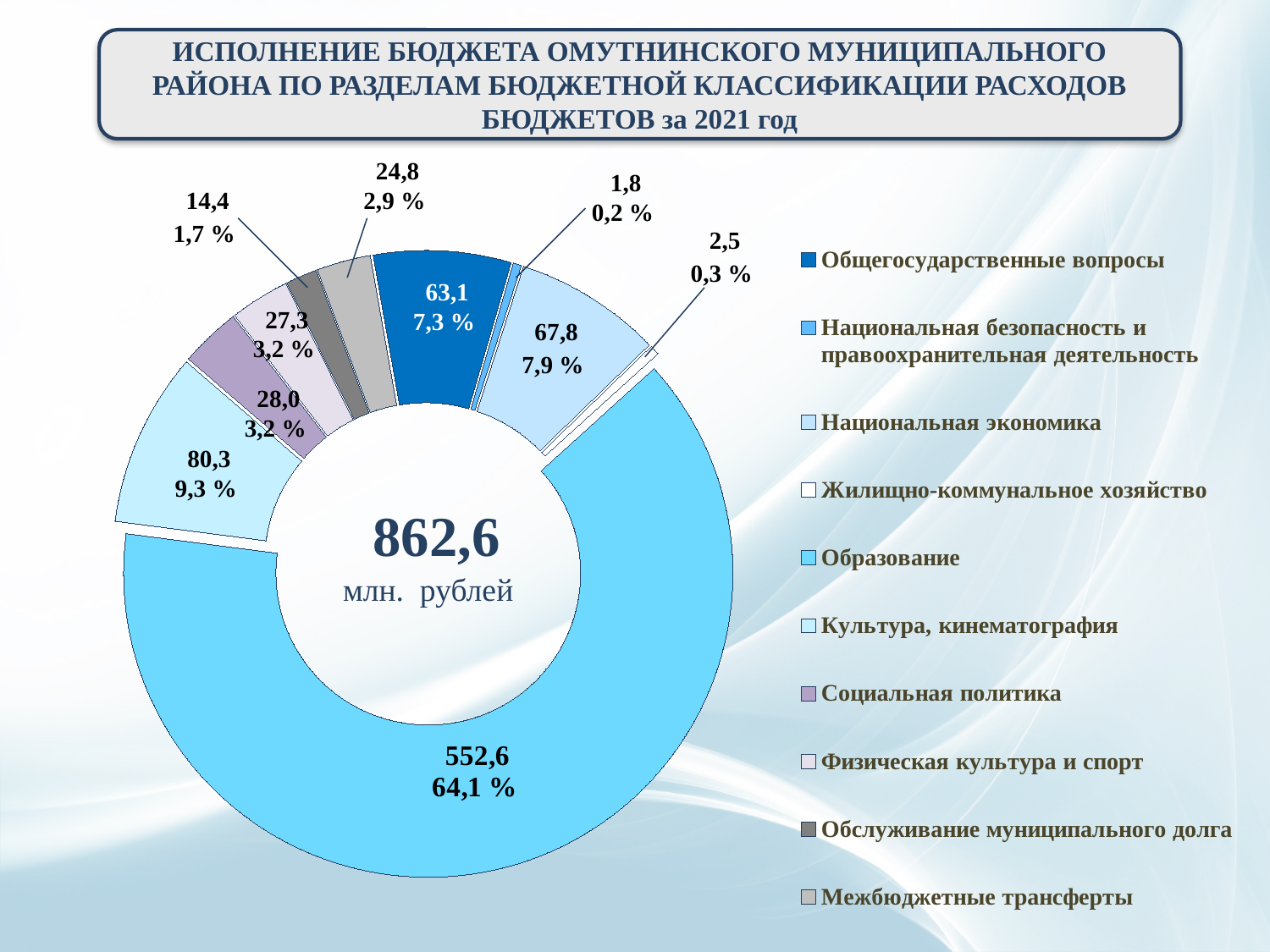
What kind of chart is shown on the slide? doughnut (pie) chart What value is shown for Обслуживание муниципального долга? 14,4 Which category has the largest share of the budget? Образование What share of the budget does Образование account for? 64,1 % What is the total shown in the centre of the chart? 862,6 млн. рублей Which is larger, the value for Национальная экономика or the value for Общегосударственные вопросы? Национальная экономика What share is shown for Культура, кинематография? 9,3 % How many categories does the legend list? 10 What value is shown for Национальная экономика? 67,8 What is the difference between the values for Культура, кинематография and Общегосударственные вопросы? 17,2 What value is shown for Образование? 552,6 Which category has the smallest share of the budget? Национальная безопасность и правоохранительная деятельность